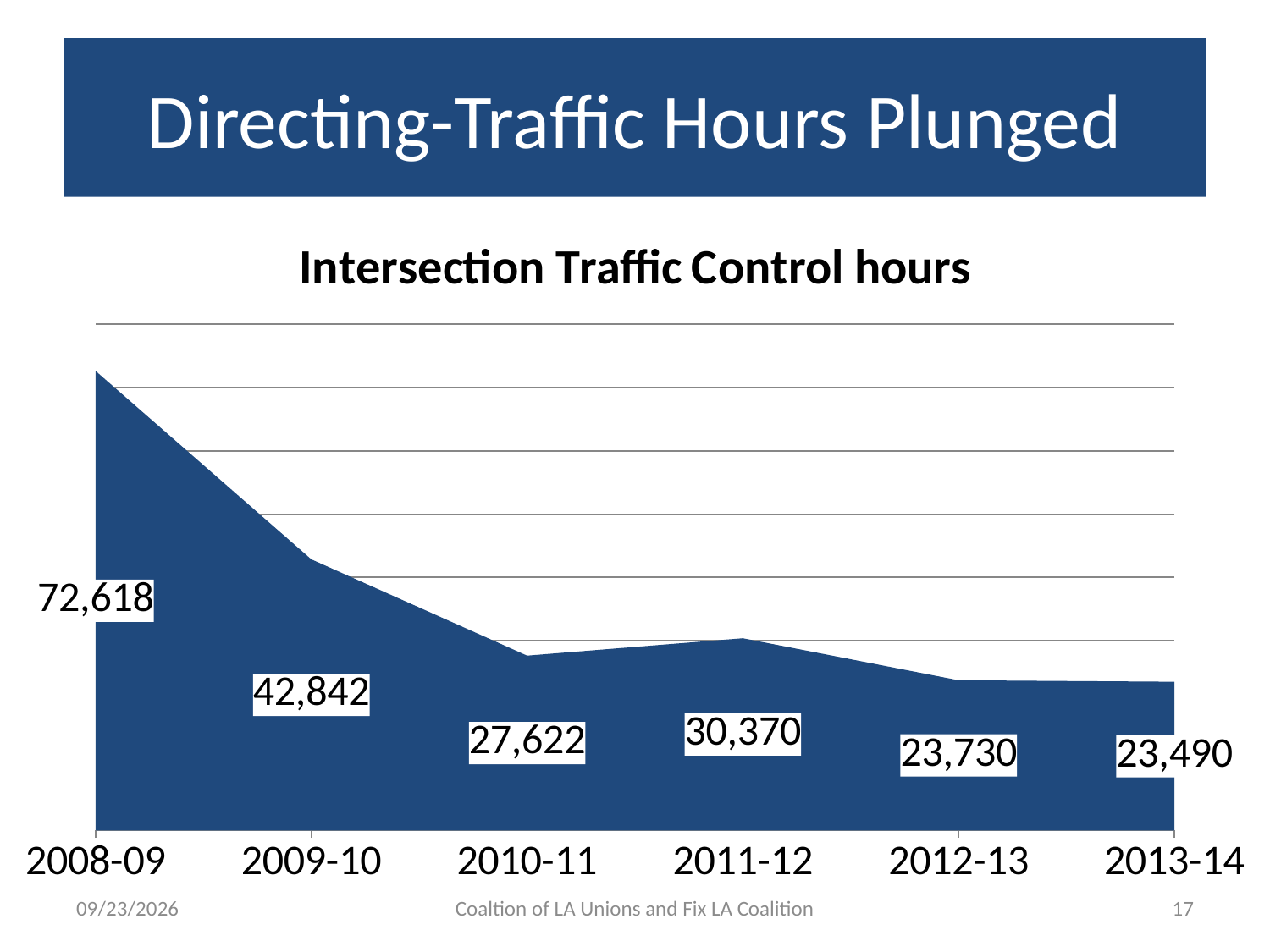
What is the value for 2013-14 in the Intersection Traffic Control hours chart? 23,490 Do the values generally rise or fall from 2008-09 to 2013-14? Fall How many years are plotted in the chart? 6 What is the difference between the 2011-12 and 2010-11 values? 2,748 What is the value for 2011-12 in the Intersection Traffic Control hours chart? 30,370 Which is larger, the value for 2010-11 or the value for 2011-12? 2011-12 Which year has the lowest Intersection Traffic Control hours? 2013-14 Which year has the highest Intersection Traffic Control hours? 2008-09 What is the title of the chart? Intersection Traffic Control hours What is the value for 2008-09 in the Intersection Traffic Control hours chart? 72,618 What kind of chart is shown on the slide? Area chart What is the difference between the 2008-09 and 2009-10 values? 29,776